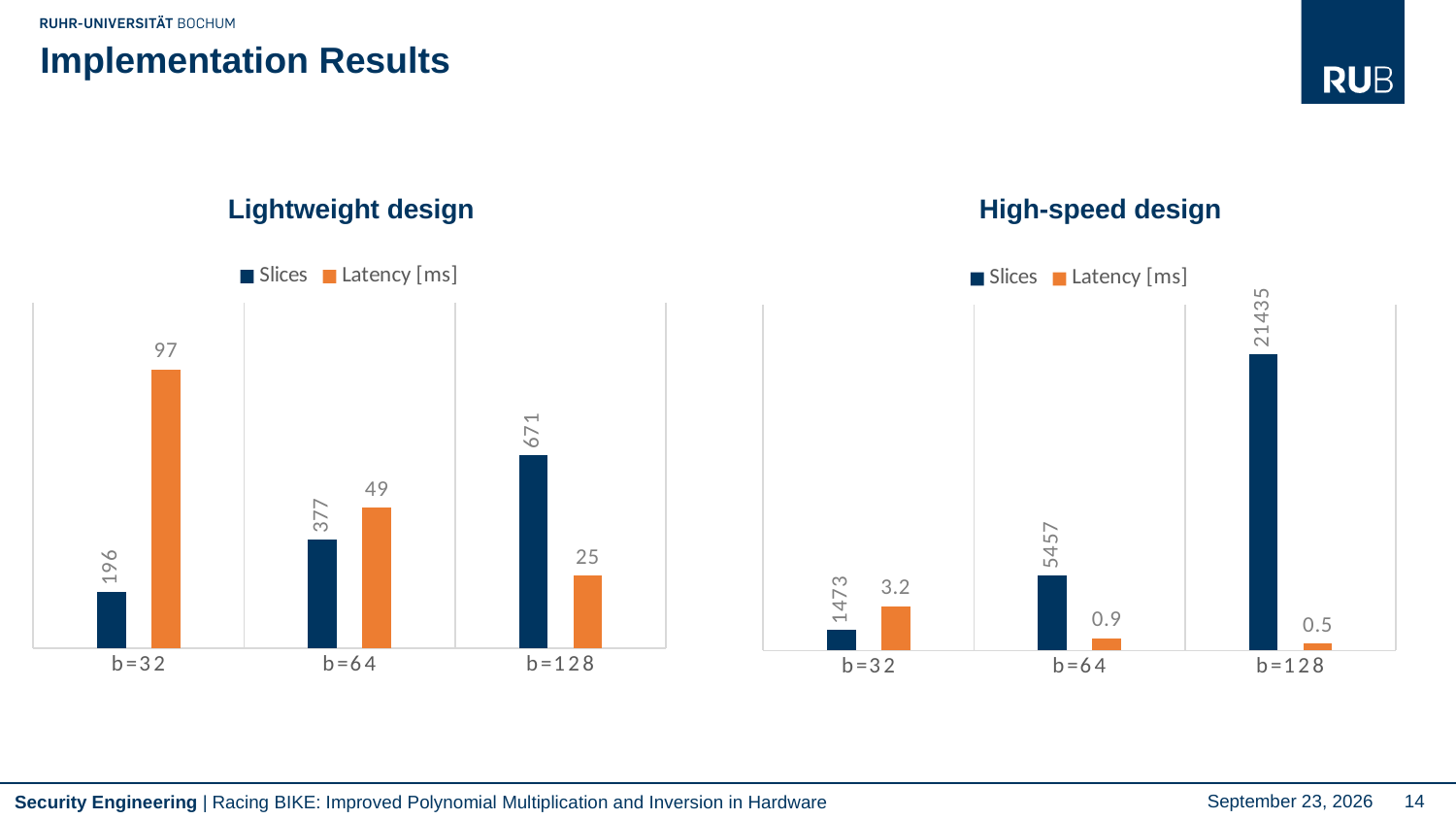
In the High-speed design chart, what is the Slices value for b=128? 21435 In the High-speed design chart, what is the difference in Latency [ms] between b=64 and b=128? 0.4 How many series does the legend of the Lightweight design chart list? 2 In the High-speed design chart, which category has the lowest Slices value? b=32 How many categories are shown in the High-speed design chart? 3 In the High-speed design chart, what is the Latency [ms] value for b=32? 3.2 In the Lightweight design chart, what is the Slices value for b=32? 196 In the Lightweight design chart, what is the Latency [ms] value for b=128? 25 In the Lightweight design chart, which is larger for b=64: Slices or Latency [ms]? Slices In the Lightweight design chart, what is the difference in Slices between b=128 and b=64? 294 What type of chart is the High-speed design chart? Bar chart In the Lightweight design chart, which category has the highest Latency [ms]? b=32